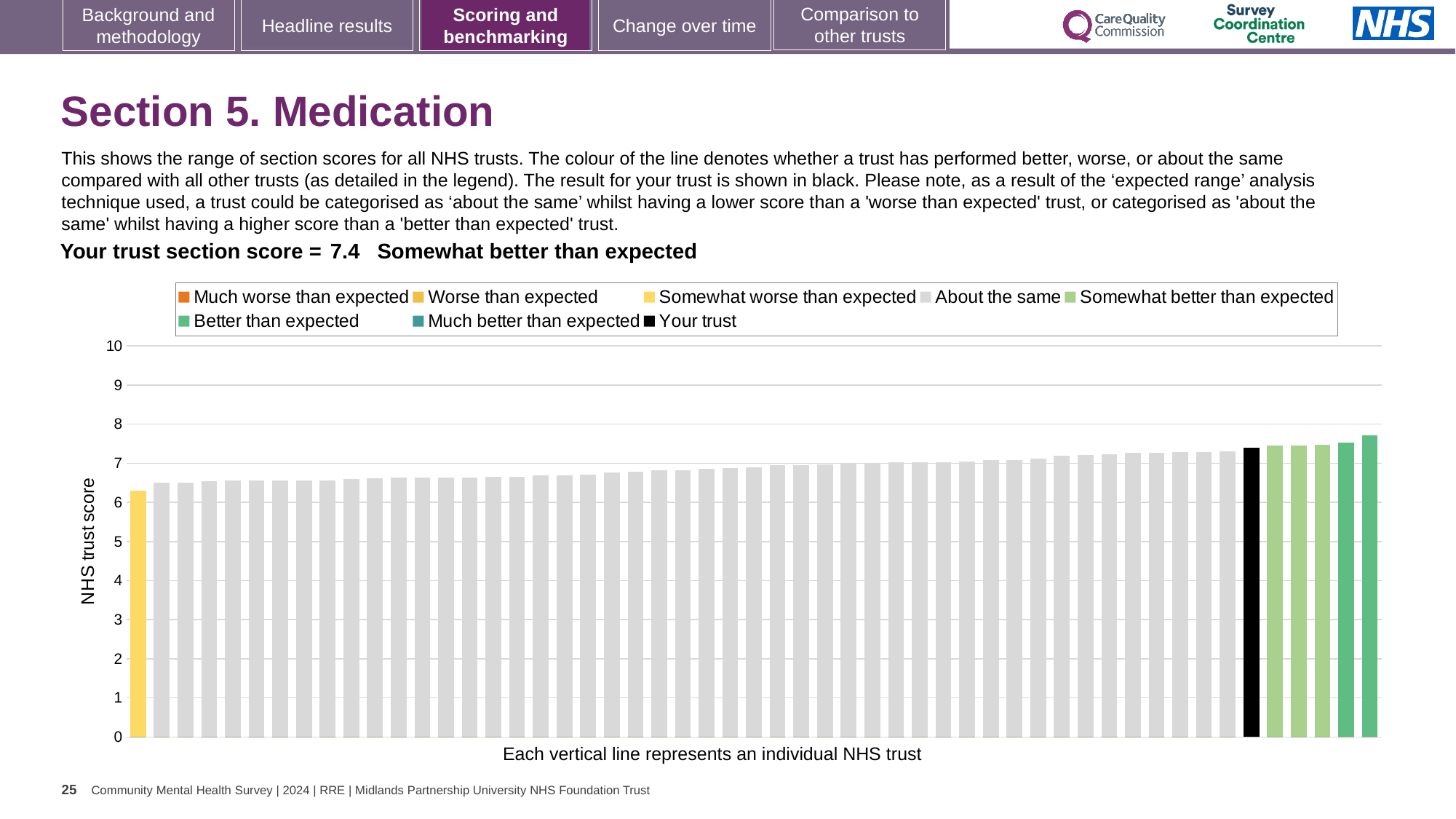
Is the value of the black bar (your trust) greater or less than 7? greater Is the value of the leftmost (yellow) bar greater or less than 7? less Which legend category does the highest bar on the chart belong to? Better than expected Do the bar values rise or fall from left to right along the x axis? rise Is the value of the rightmost bar greater or less than 7? greater How many entries does the chart legend list? 8 What is the label on the y axis of the chart? NHS trust score What type of chart is shown on the slide? bar chart What colour is used for the bar representing your trust? black Which is larger: the value of the black bar (your trust) or the value of the leftmost bar? the black bar (your trust) What is the section score for your trust shown on the slide? 7.4